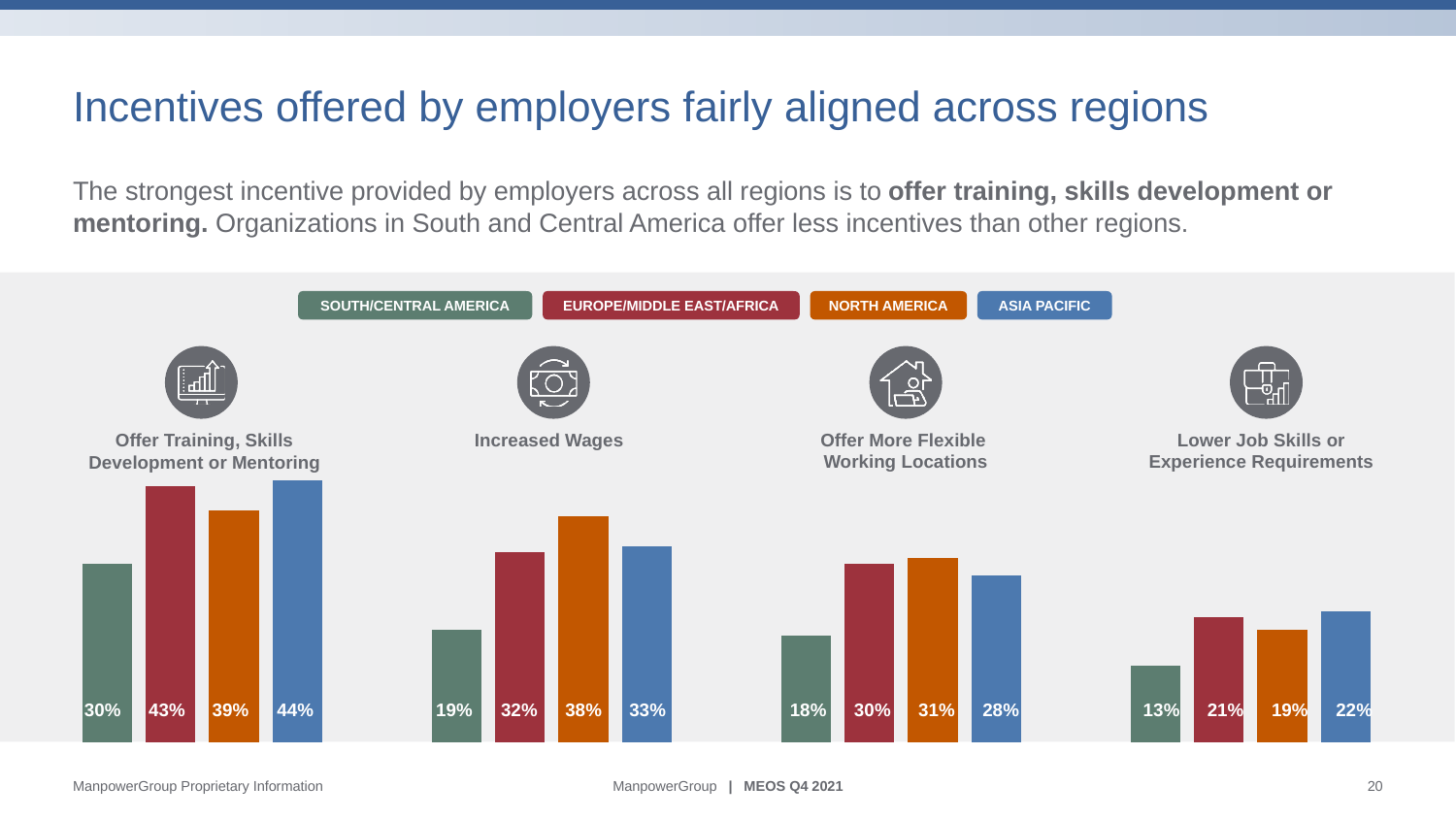
How many regions does the legend list? 4 In the 'Lower Job Skills or Experience Requirements' chart, what is the difference between Europe/Middle East/Africa and North America? 2% In the 'Increased Wages' chart, what is the value for North America? 38% In the 'Increased Wages' chart, which region has the lowest value? South/Central America In the 'Offer Training, Skills Development or Mentoring' chart, what is the value for Asia Pacific? 44% In the 'Offer More Flexible Working Locations' chart, which is larger: Europe/Middle East/Africa or Asia Pacific? Europe/Middle East/Africa Which colour represents North America in the legend? Orange What kind of chart is used to show the incentives on this slide? Bar chart In the 'Offer More Flexible Working Locations' chart, what is the value for South/Central America? 18% How many bars are in the 'Increased Wages' chart? 4 In the 'Offer Training, Skills Development or Mentoring' chart, what is the difference between Europe/Middle East/Africa and South/Central America? 13% In the 'Lower Job Skills or Experience Requirements' chart, which region has the highest value? Asia Pacific